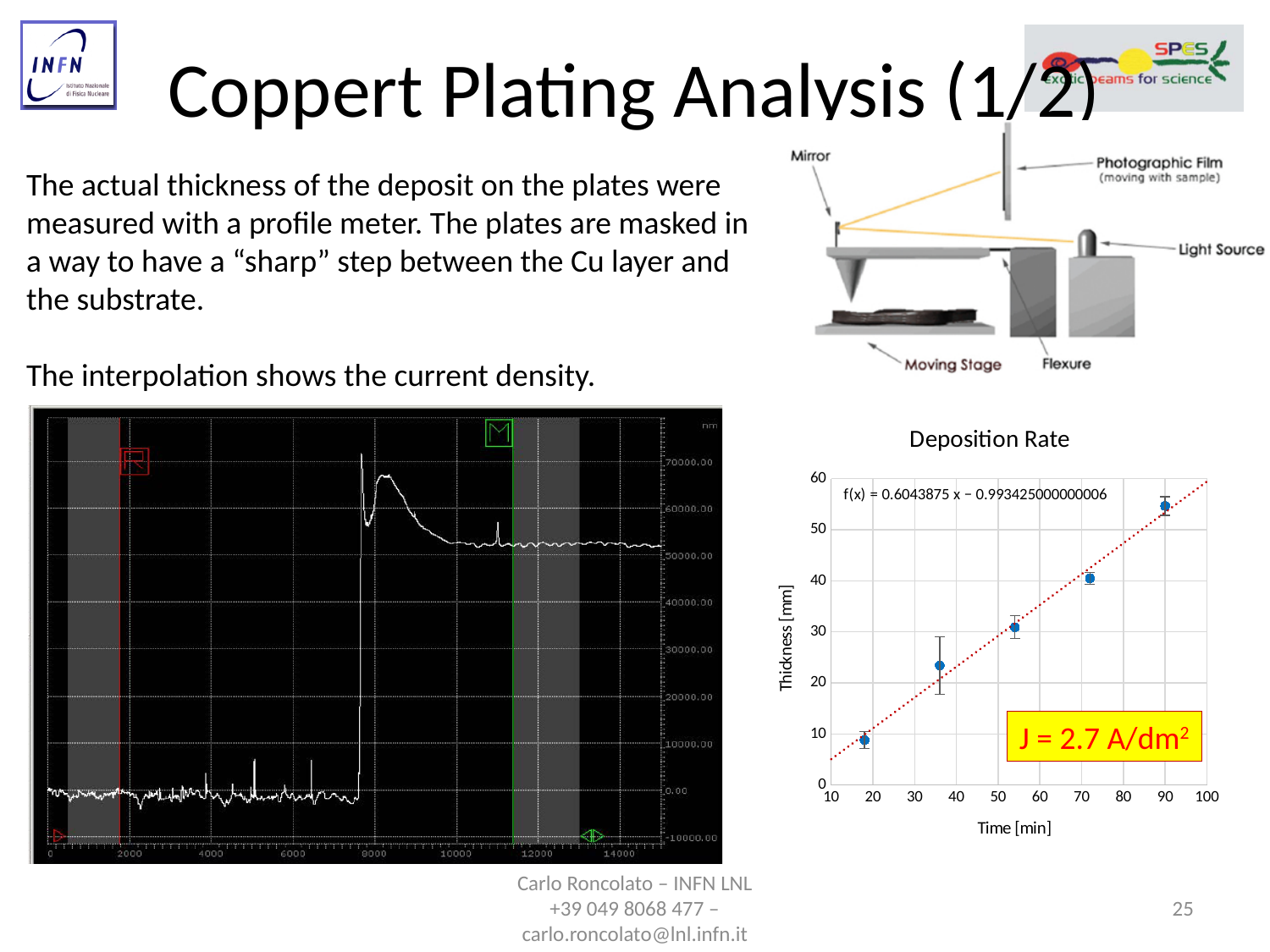
In the Deposition Rate chart, what is the label of the x axis? Time [min] In the Deposition Rate chart, is the thickness at 36 min greater or less than 30? less In the Deposition Rate chart, how many data points are plotted? 5 In the Deposition Rate chart, is the thickness at 18 min greater or less than 10? less In the Deposition Rate chart, is the thickness at 90 min greater or less than 50? greater In the Deposition Rate chart, at which time is the thickness highest? 90 min In the Deposition Rate chart, at which time is the thickness lowest? 18 min In the Deposition Rate chart, which has the larger thickness: the point at 54 min or the point at 72 min? 72 min In the Deposition Rate chart, what kind of chart is used to show the data? scatter chart What is the title of the chart on the right side of the slide? Deposition Rate In the Deposition Rate chart, does thickness rise or fall as time increases? rise